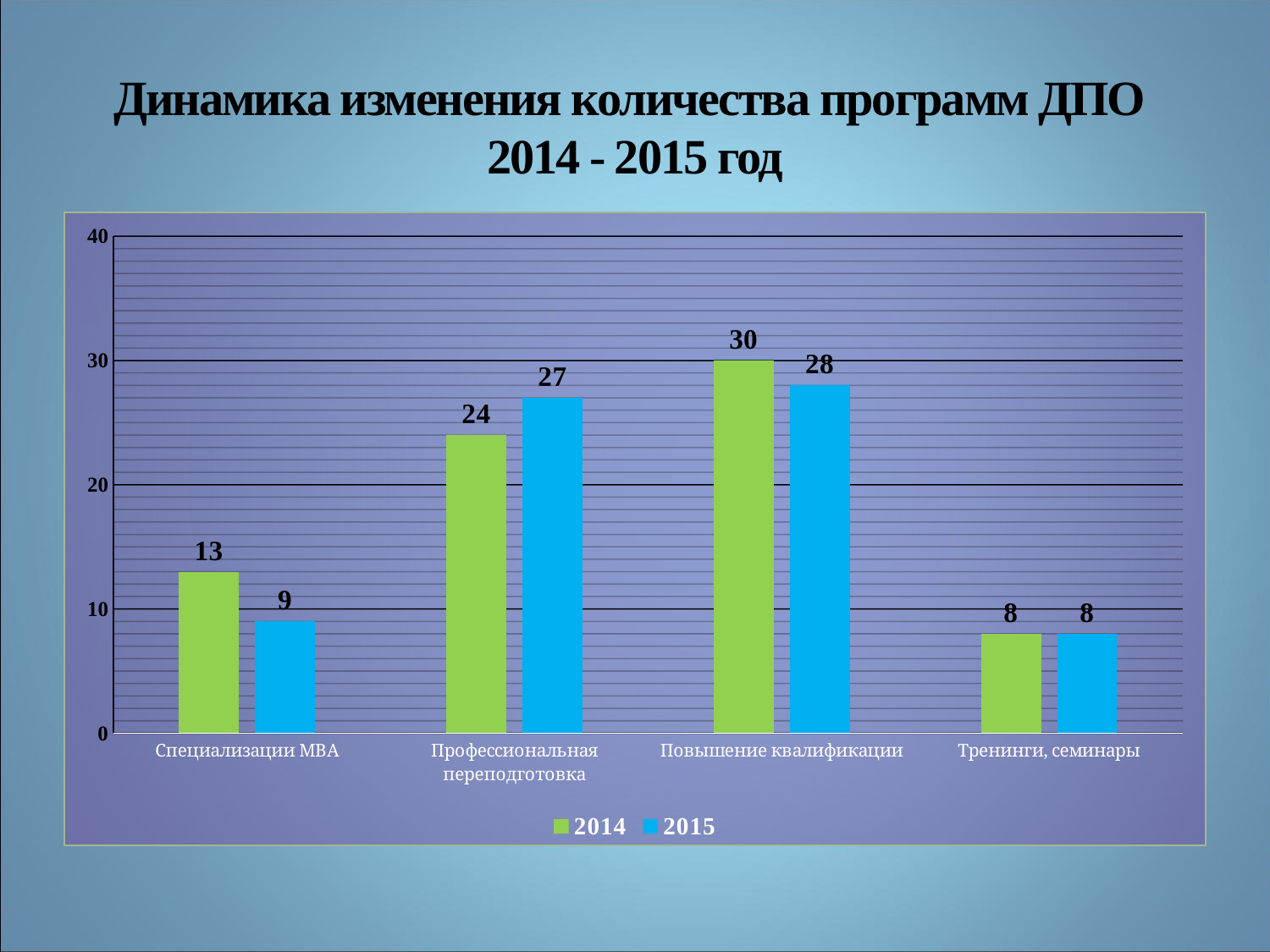
What kind of chart is shown on the slide? Bar chart What is the difference between the 2015 values for Повышение квалификации and Профессиональная переподготовка? 1 Which colour represents the 2015 series in the legend? Blue What is the difference between the 2014 and 2015 values for Специализации MBA? 4 How many categories are shown on the x axis? 4 How many series does the legend list? 2 What is the value for Специализации MBA in 2014? 13 Which category has the lowest value in 2015? Тренинги, семинары What is the value for Профессиональная переподготовка in 2015? 27 Which category has the highest value in 2014? Повышение квалификации Which is larger for Профессиональная переподготовка: the 2014 value or the 2015 value? 2015 What is the value for Тренинги, семинары in 2015? 8